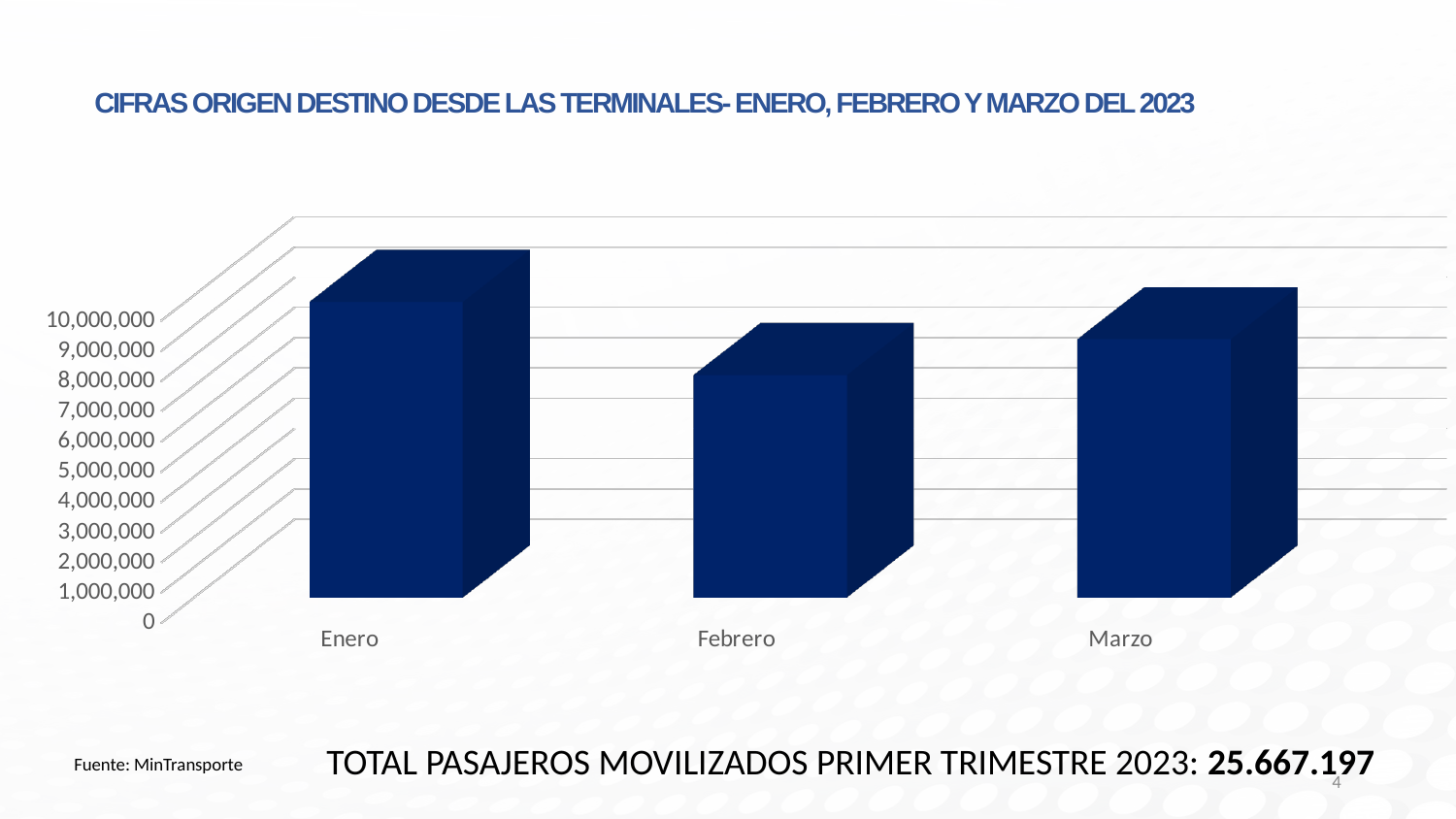
Is the value for Marzo greater or less than 7,000,000? greater Is the value for Enero greater or less than 8,000,000? greater What kind of chart is shown on the slide? bar chart What is the highest value shown on the vertical axis of the chart? 10,000,000 What is the title of the chart on the slide? CIFRAS ORIGEN DESTINO DESDE LAS TERMINALES- ENERO, FEBRERO Y MARZO DEL 2023 Which is larger, the value for Enero or the value for Marzo? Enero Which month has the lowest bar in the chart? Febrero Which month has the highest bar in the chart? Enero Is the value for Febrero greater or less than 10,000,000? less How many months (categories) are plotted in the chart? 3 Which is larger, the value for Febrero or the value for Marzo? Marzo Does the value fall or rise from Enero to Febrero? fall